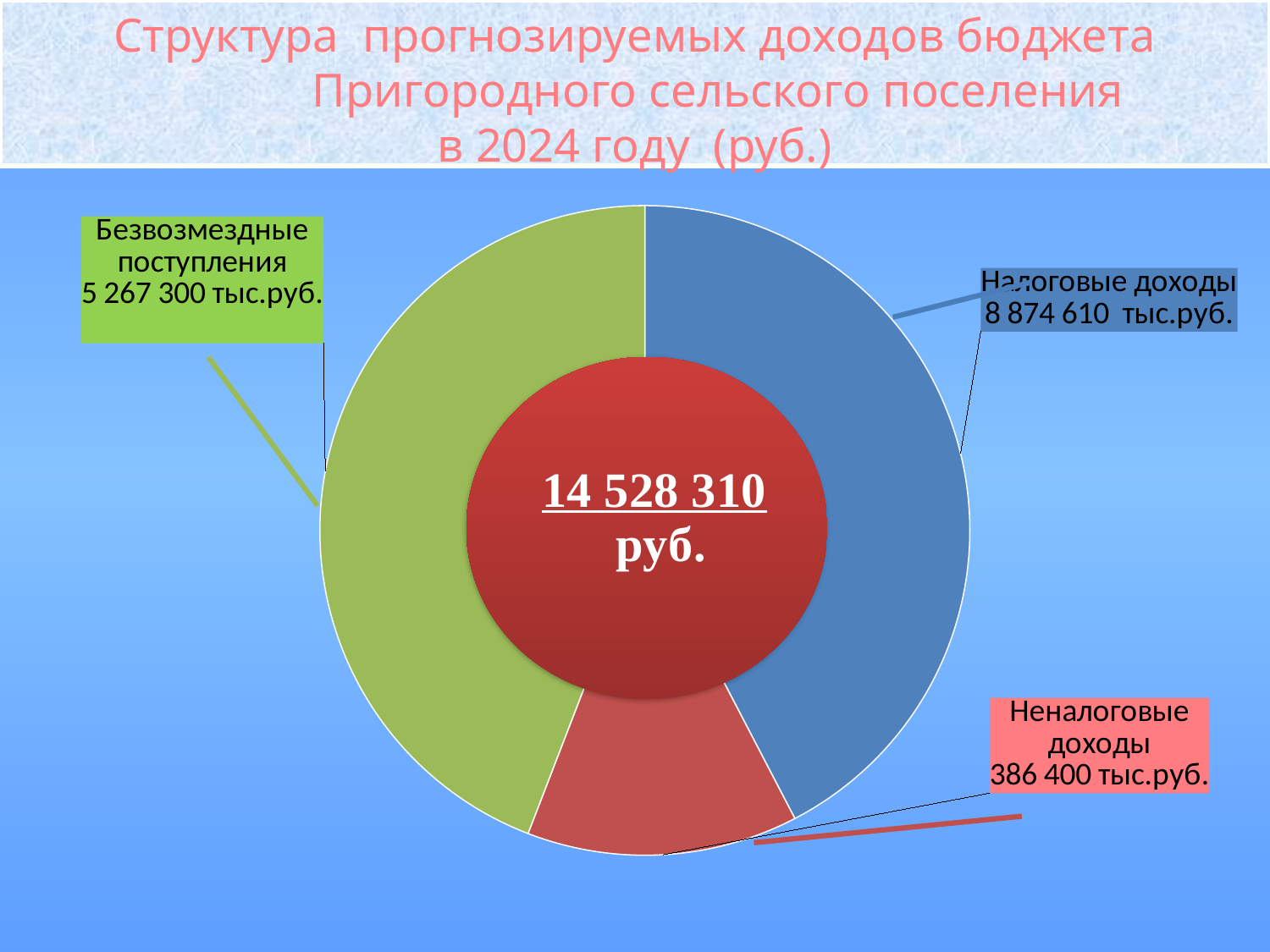
What is the value for Неналоговые доходы? 386 400 тыс.руб. What is the difference between Налоговые доходы and Безвозмездные поступления? 3 607 310 тыс.руб. What is the value for Налоговые доходы? 8 874 610 тыс.руб. What is the difference between Безвозмездные поступления and Неналоговые доходы? 4 880 900 тыс.руб. Which is larger, Безвозмездные поступления or Неналоговые доходы? Безвозмездные поступления Which category has the smallest share of the chart? Неналоговые доходы What colour is the slice for Налоговые доходы? Blue What total amount is shown in the centre of the chart? 14 528 310 руб. How many categories are shown in the chart? 3 What kind of chart is shown on the slide? Doughnut chart What is the value for Безвозмездные поступления? 5 267 300 тыс.руб.